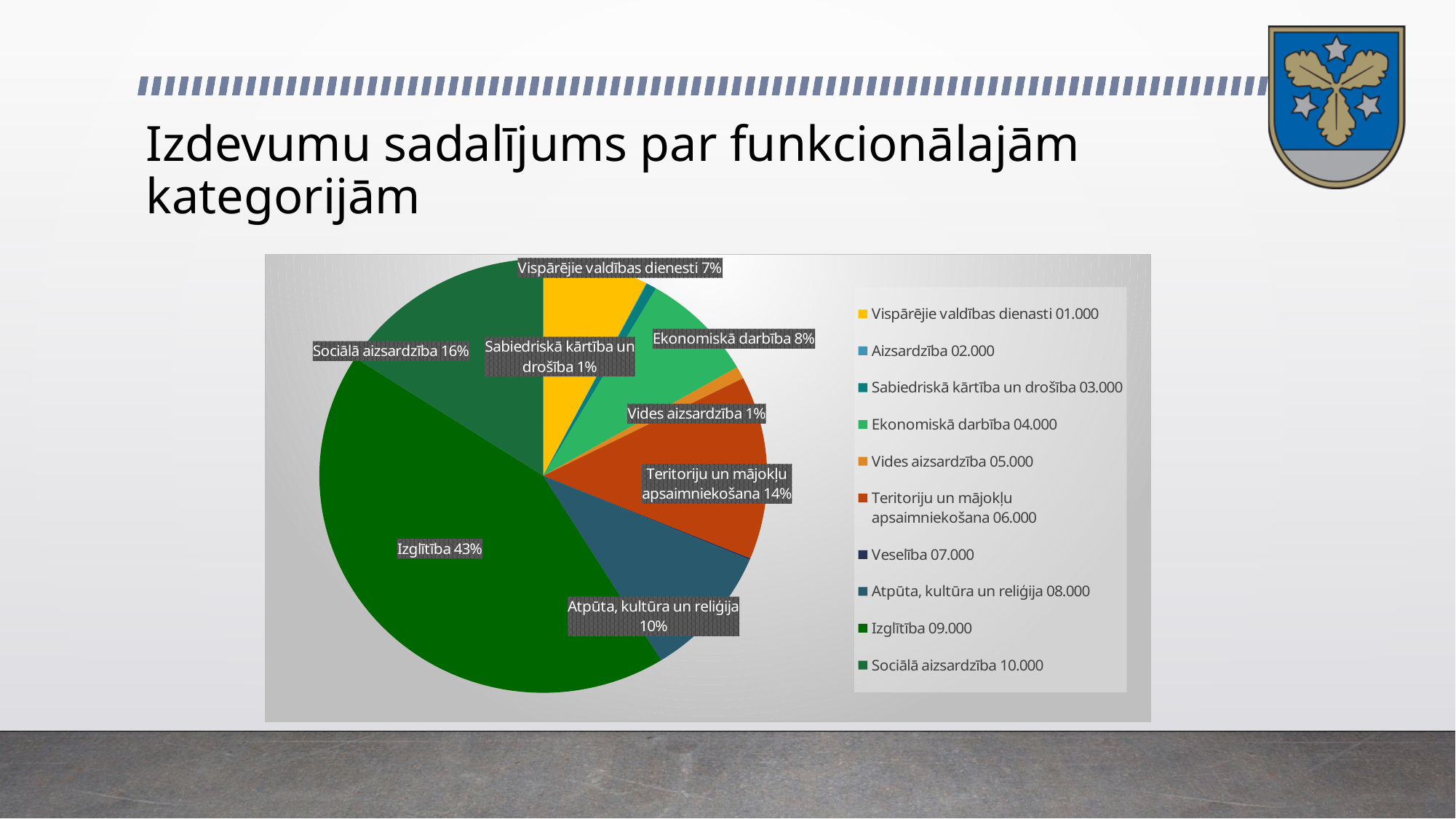
What share of the pie does Sociālā aizsardzība have? 16% What share of the pie does Teritoriju un mājokļu apsaimniekošana have? 14% What share of the pie does Vispārējie valdības dienesti have? 7% What is the difference in percentage points between Izglītība and Sociālā aizsardzība? 27 What colour is the Izglītība slice in the pie chart? dark green What kind of chart is shown on the slide? pie chart Which category has the largest slice of the pie? Izglītība How many entries does the legend list? 10 Which is larger, the slice for Sociālā aizsardzība or the slice for Teritoriju un mājokļu apsaimniekošana? Sociālā aizsardzība